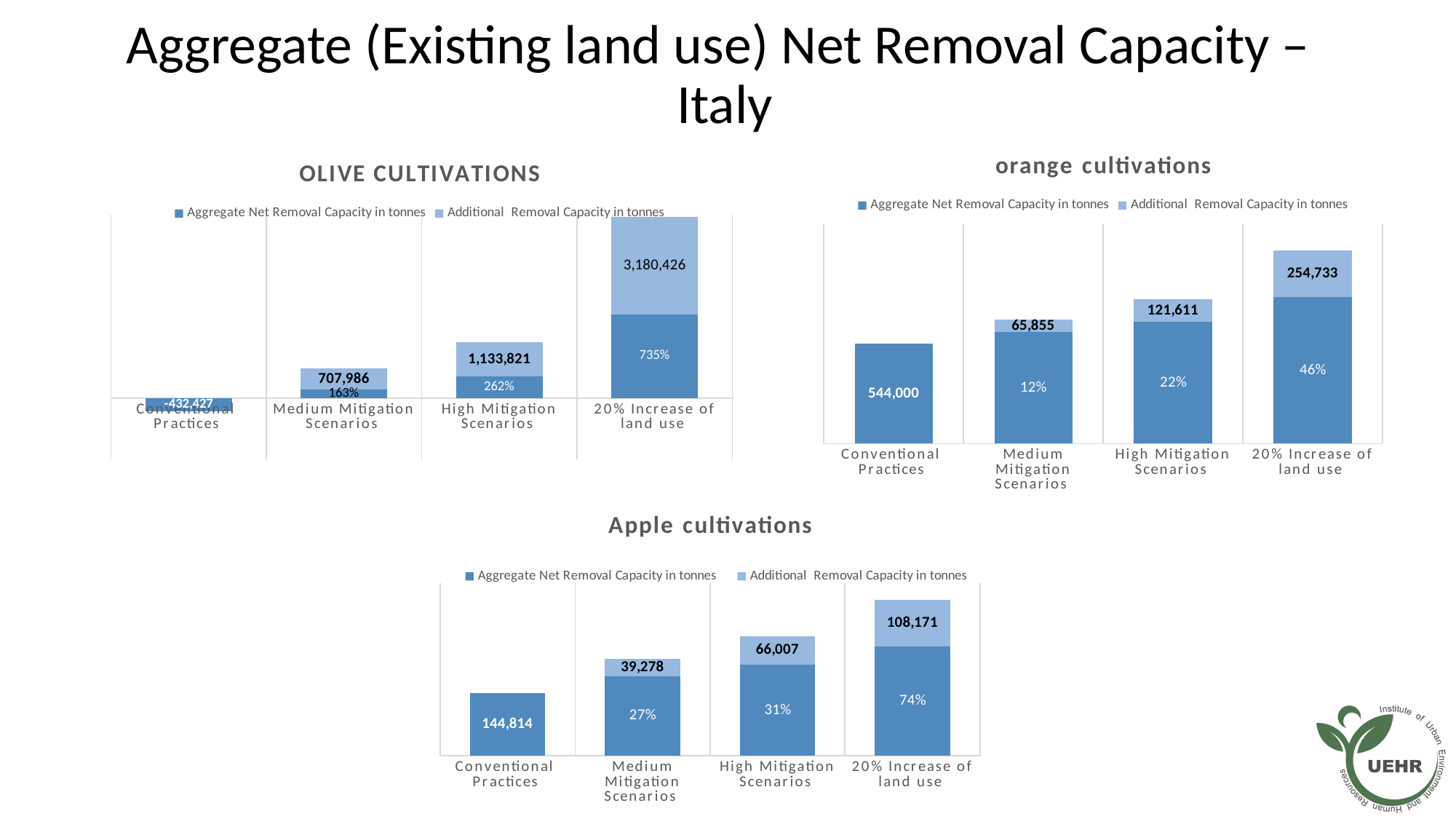
In the Apple cultivations chart, what tonnes value is printed on the Medium Mitigation Scenarios bar? 39,278 In the OLIVE CULTIVATIONS chart, what value is printed on the Conventional Practices bar? -432,427 How many series does the legend of the orange cultivations chart list? 2 In the Apple cultivations chart, what value is printed on the Conventional Practices bar? 144,814 In the orange cultivations chart, which category has the tallest bar? 20% Increase of land use In the orange cultivations chart, what value is printed on the Conventional Practices bar? 544,000 In the OLIVE CULTIVATIONS chart, what tonnes value is printed on the 20% Increase of land use bar? 3,180,426 In the OLIVE CULTIVATIONS chart, which category has the lowest bar? Conventional Practices In the orange cultivations chart, what percentage is printed on the High Mitigation Scenarios bar? 22% In the Apple cultivations chart, what percentage is printed on the 20% Increase of land use bar? 74% In the Apple cultivations chart, how many categories are shown on the x axis? 4 What type of chart is the Apple cultivations chart? Stacked bar chart